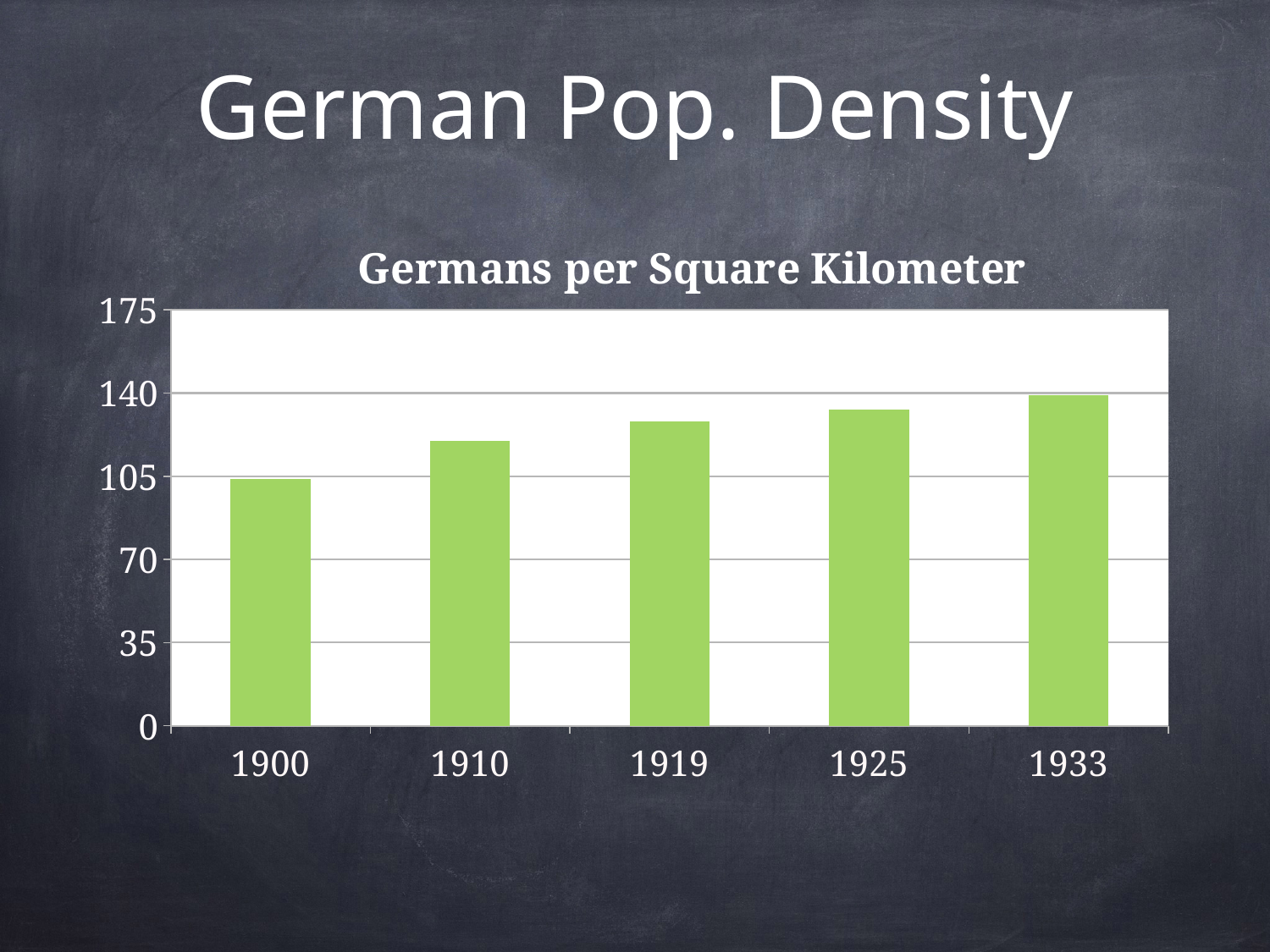
What is the title of the chart? Germans per Square Kilometer Which year has the highest value in the chart? 1933 Which year has the larger value, 1910 or 1925? 1925 What kind of chart is shown on the slide? bar chart Is the value for 1910 greater or less than 105? greater Do the values rise or fall from 1900 to 1933? rise What colour are the bars in the chart? green Which year has the lowest value in the chart? 1900 Is the value for 1919 greater or less than 140? less How many years are shown on the x axis of the chart? 5 Is the value for 1900 greater or less than 70? greater Which year has the larger value, 1900 or 1919? 1919